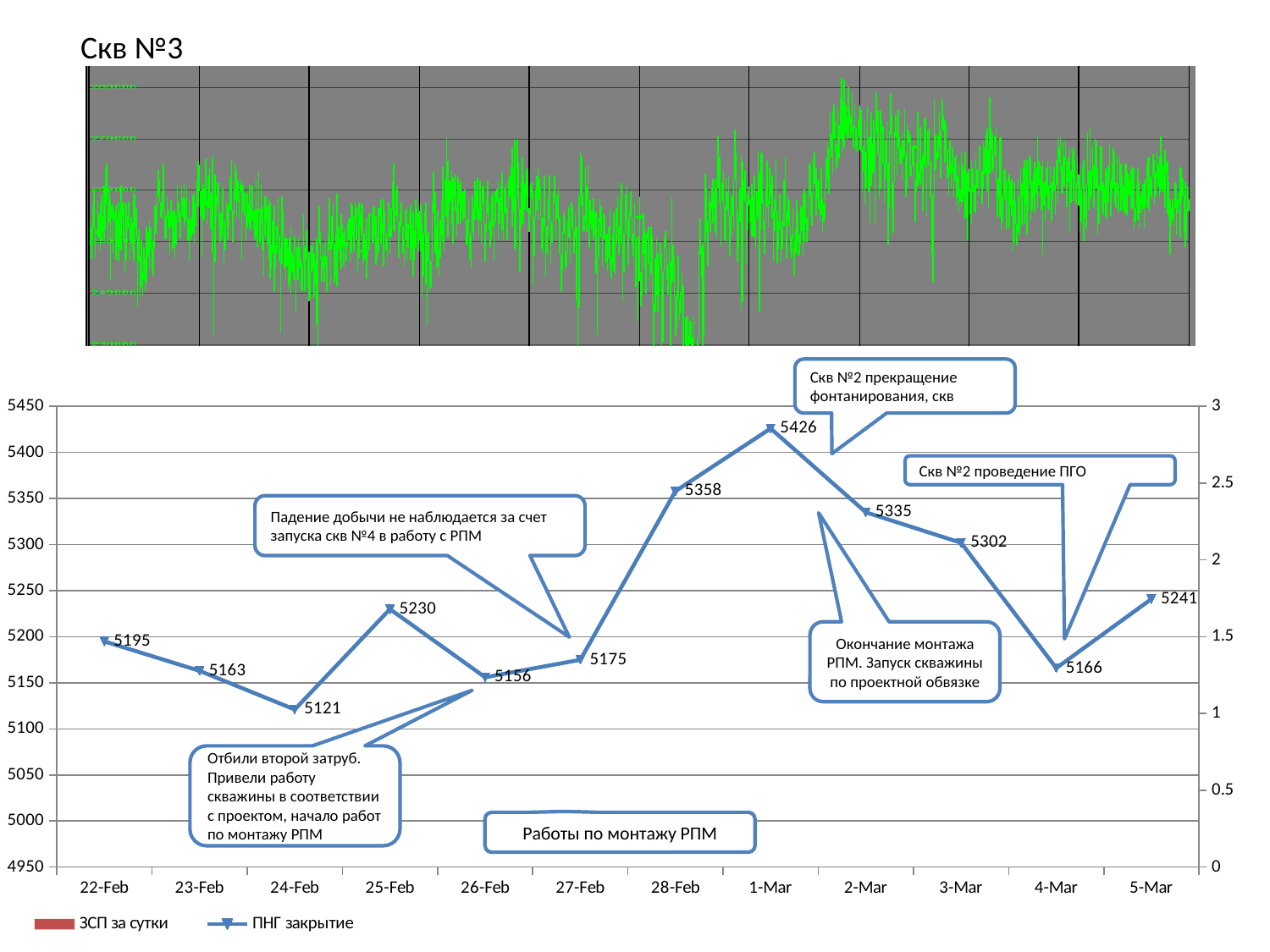
How many series does the legend of the lower chart list? 2 On the lower line chart, is the value on 3-Mar greater or less than 5300? greater On the lower line chart, which date has the lowest value? 24-Feb On the lower line chart, what is the difference between the values on 28-Feb and 27-Feb? 183 How many dates are plotted on the lower line chart? 12 On the lower line chart, what is the value labelled on 24-Feb? 5121 What kind of chart is the lower chart on the slide? line chart On the lower line chart, which date has the highest value? 1-Mar On the lower line chart, what is the ПНГ закрытие value on 1-Mar? 5426 On the lower line chart, what is the value on 5-Mar? 5241 On the lower line chart, which is larger, the value on 25-Feb or the value on 26-Feb? 25-Feb On the lower line chart, what is the difference between the values on 1-Mar and 24-Feb? 305